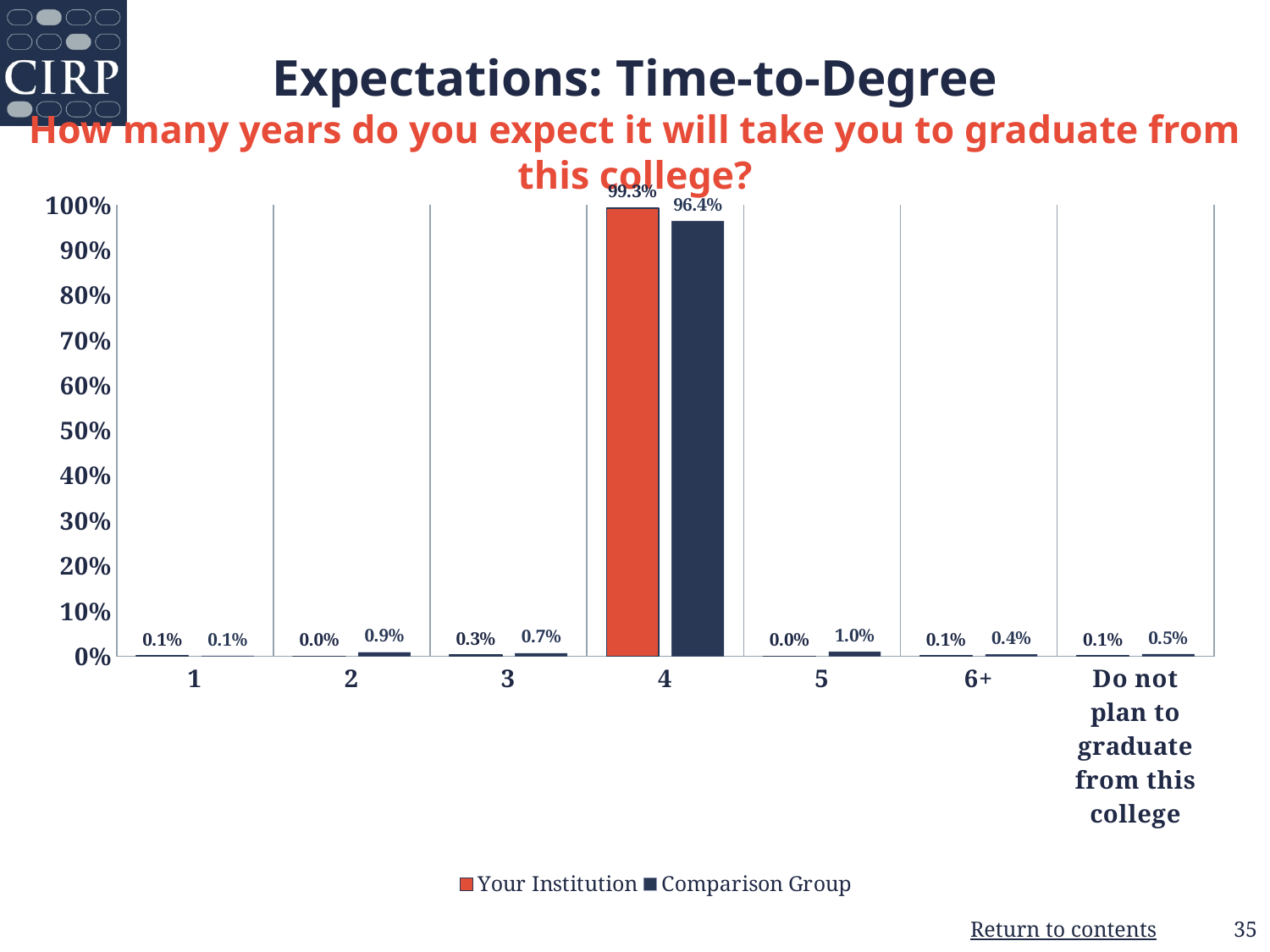
How many series does the legend list? 2 What is the value for Your Institution in the 4 years category? 99.3% What is the value for Comparison Group in the 2 years category? 0.9% What is the value for Comparison Group in the 'Do not plan to graduate from this college' category? 0.5% Is the value for Comparison Group in the 4 years category greater or less than 90%? greater What is the value for Your Institution in the 3 years category? 0.3% Which category has the highest value for Your Institution? 4 What is the difference between Your Institution and Comparison Group in the 4 years category? 2.9% How many categories are shown on the x axis? 7 What is the value for Comparison Group in the 4 years category? 96.4% What kind of chart is shown on the slide? bar chart In the 5 years category, which series has the larger value, Your Institution or Comparison Group? Comparison Group